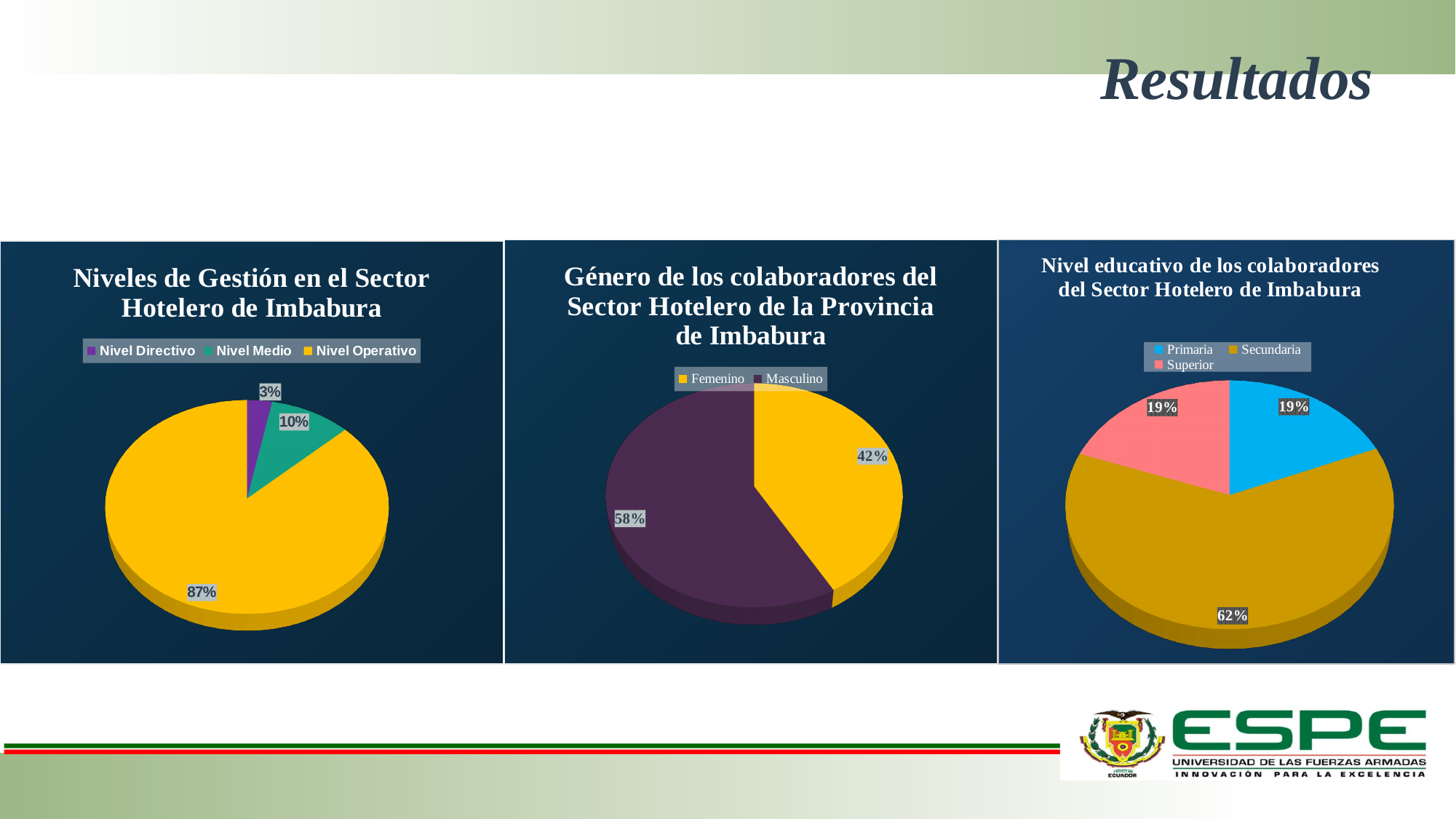
In the middle chart 'Género de los colaboradores del Sector Hotelero de la Provincia de Imbabura', what share is Masculino? 58% In the right chart 'Nivel educativo de los colaboradores del Sector Hotelero de Imbabura', what is the difference between the Secundaria and Primaria shares? 43% In the left chart 'Niveles de Gestión en el Sector Hotelero de Imbabura', how many categories does the legend list? 3 In the left chart 'Niveles de Gestión en el Sector Hotelero de Imbabura', which category has the smallest slice? Nivel Directivo In the middle chart 'Género de los colaboradores del Sector Hotelero de la Provincia de Imbabura', what is the difference between the Masculino and Femenino shares? 16% In the right chart 'Nivel educativo de los colaboradores del Sector Hotelero de Imbabura', what share is Secundaria? 62% In the right chart 'Nivel educativo de los colaboradores del Sector Hotelero de Imbabura', which category has the largest slice? Secundaria In the left chart 'Niveles de Gestión en el Sector Hotelero de Imbabura', what share does Nivel Directivo have? 3% In the right chart 'Nivel educativo de los colaboradores del Sector Hotelero de Imbabura', what colour is the Superior slice? Pink What kind of chart is the middle chart 'Género de los colaboradores del Sector Hotelero de la Provincia de Imbabura'? Pie chart In the middle chart 'Género de los colaboradores del Sector Hotelero de la Provincia de Imbabura', which is larger, Femenino or Masculino? Masculino